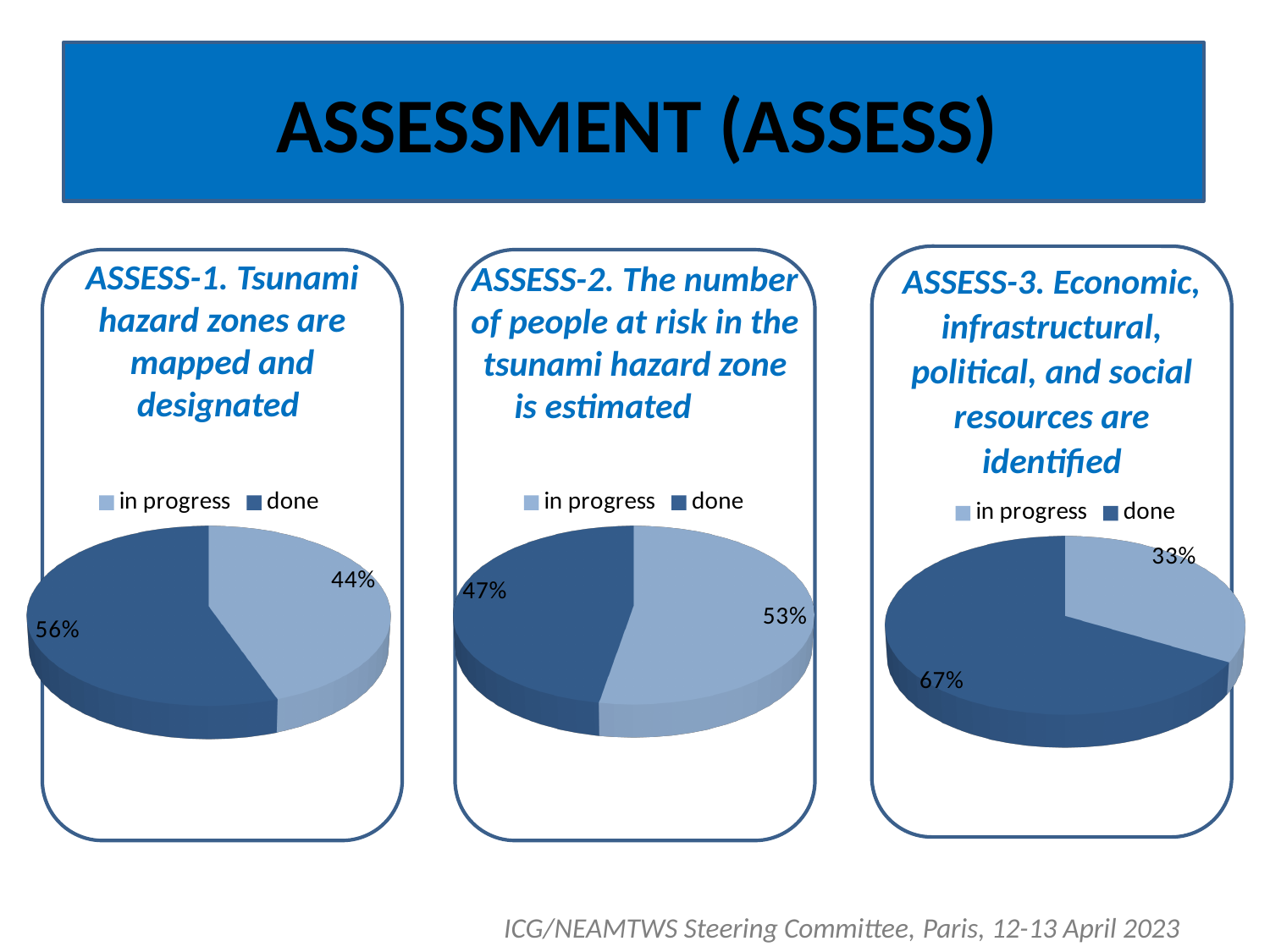
In the ASSESS-3 chart, what percentage is labelled 'in progress'? 33% In the ASSESS-2 chart, what percentage is labelled 'in progress'? 53% In the ASSESS-1 chart, what is the difference between the 'done' and 'in progress' percentages? 12% In the ASSESS-1 chart, what percentage is labelled 'done'? 56% In the ASSESS-2 chart, which slice is larger, 'in progress' or 'done'? in progress What kind of chart is used in the ASSESS-2 box? Pie chart In the ASSESS-1 chart, what percentage is labelled 'in progress'? 44% In the ASSESS-3 chart, which slice is larger, 'in progress' or 'done'? done How many entries does the legend of the ASSESS-1 chart list? 2 In the ASSESS-3 chart, what is the difference between the 'done' and 'in progress' percentages? 34% In the ASSESS-3 chart, what percentage is labelled 'done'? 67% In the ASSESS-2 chart, what percentage is labelled 'done'? 47%